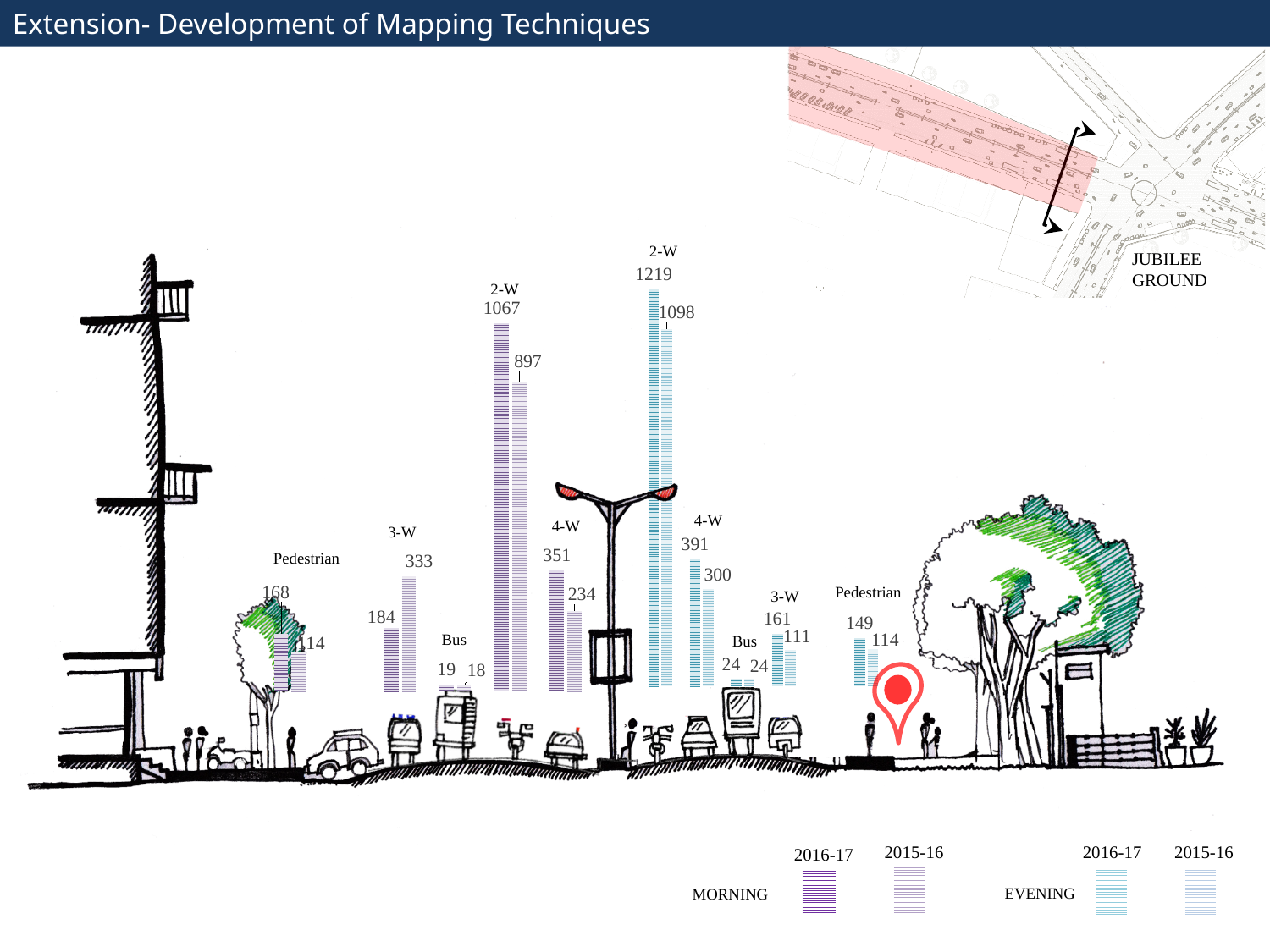
In the MORNING chart, which category has the highest 2016-17 value? 2-W In the MORNING chart, which is larger for 3-W: the 2016-17 value or the 2015-16 value? 2015-16 In the MORNING chart, what is the 2016-17 value for 2-W? 1067 In the MORNING chart, what is the 2015-16 value for 3-W? 333 How many entries does the legend at the bottom of the slide list? 4 How many categories are shown in the EVENING chart? 5 In the EVENING chart, what is the 2015-16 value for Pedestrian? 114 What type of chart is used to show the MORNING and EVENING counts? Bar chart In the EVENING chart, which category has the lowest 2016-17 value? Bus In the MORNING chart, what is the difference between the 2016-17 and 2015-16 values for 2-W? 170 In the EVENING chart, what is the 2016-17 value for 2-W? 1219 In the EVENING chart, what is the difference between the 2016-17 and 2015-16 values for 4-W? 91